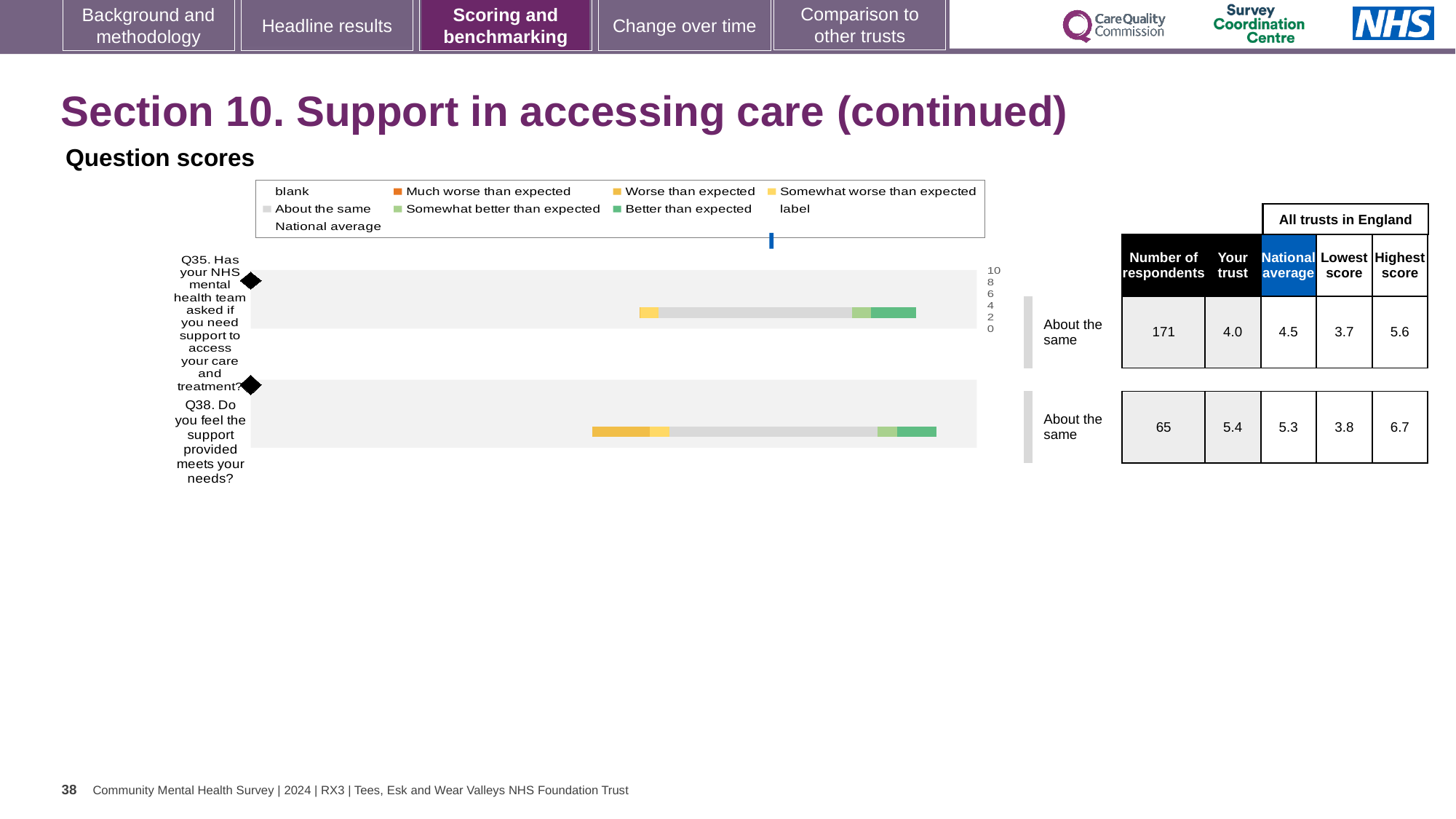
What is the difference between the highest and lowest scores among all trusts in England for Q35? 1.9 How many questions are plotted in the question scores chart? 2 What is the highest score among all trusts in England for Q35? 5.6 What is the lowest score among all trusts in England for Q38? 3.8 What benchmark category is shown next to the bar for Q38? About the same Which question has the higher 'Your trust' score, Q35 or Q38? Q38 What is the 'Your trust' score for Q35 (Has your NHS mental health team asked if you need support to access your care and treatment?)? 4.0 What kind of chart is used to show the question scores? bar chart What is the national average score for Q35? 4.5 What is the 'Your trust' score for Q38 (Do you feel the support provided meets your needs?)? 5.4 How many respondents answered Q38? 65 What is the difference between the 'Your trust' score and the national average for Q38? 0.1